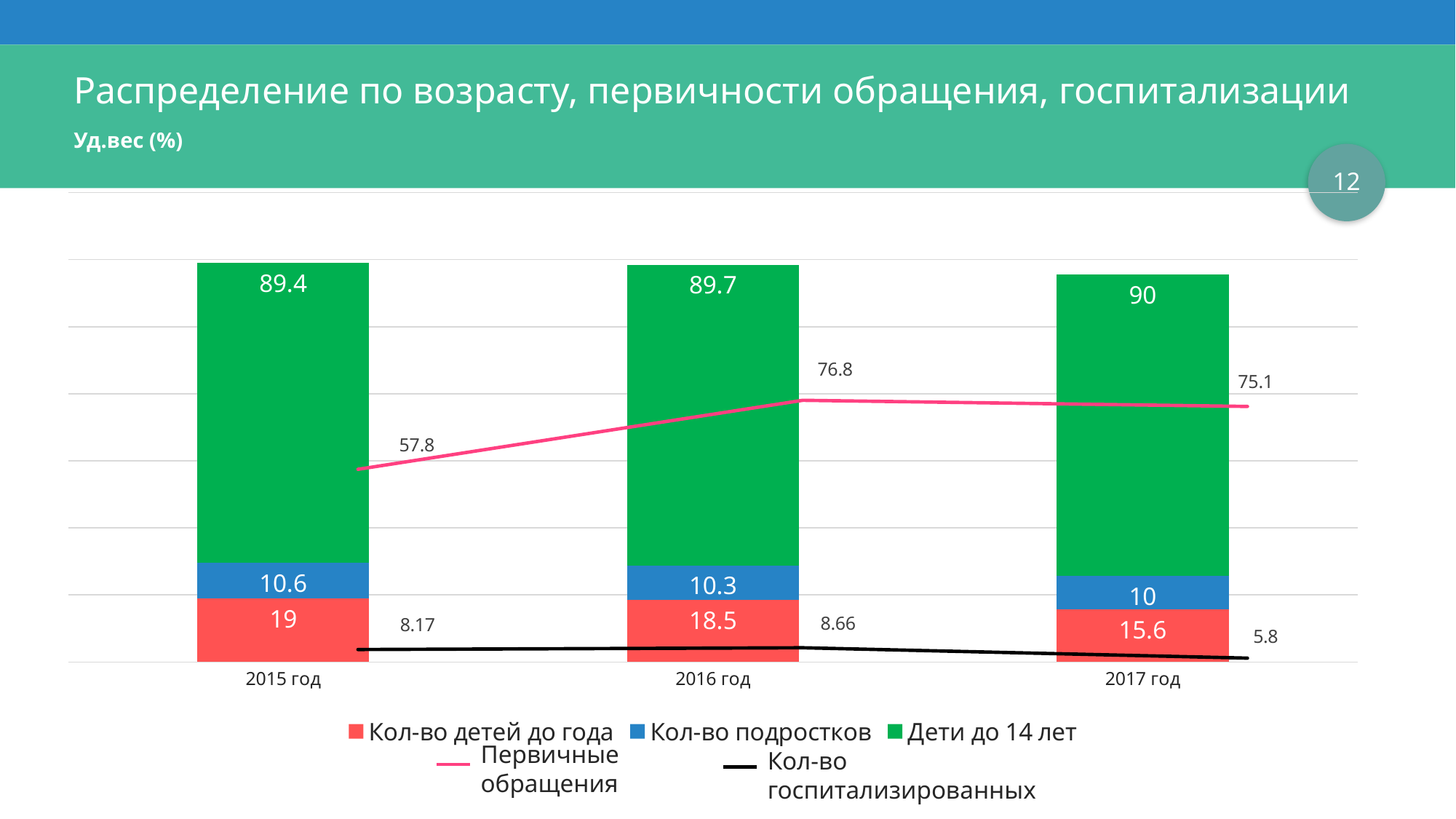
In which year is the "Кол-во госпитализированных" line at its lowest? 2017 год How many years are shown on the x axis? 3 Does the "Кол-во детей до года" series rise or fall from 2015 год to 2017 год? fall What is the total of the stacked bar for 2017 год? 115.6 What is the value for "Кол-во детей до года" in 2017 год? 15.6 What is the difference between the "Первичные обращения" values for 2016 год and 2015 год? 19 What is the value for "Дети до 14 лет" in 2016 год? 89.7 Which is larger: "Кол-во детей до года" in 2015 год or in 2017 год? 2015 год What is the value of the "Кол-во госпитализированных" line in 2016 год? 8.66 In which year is the "Первичные обращения" line at its highest? 2016 год What is the value of the "Первичные обращения" line in 2015 год? 57.8 How many series does the legend list? 5